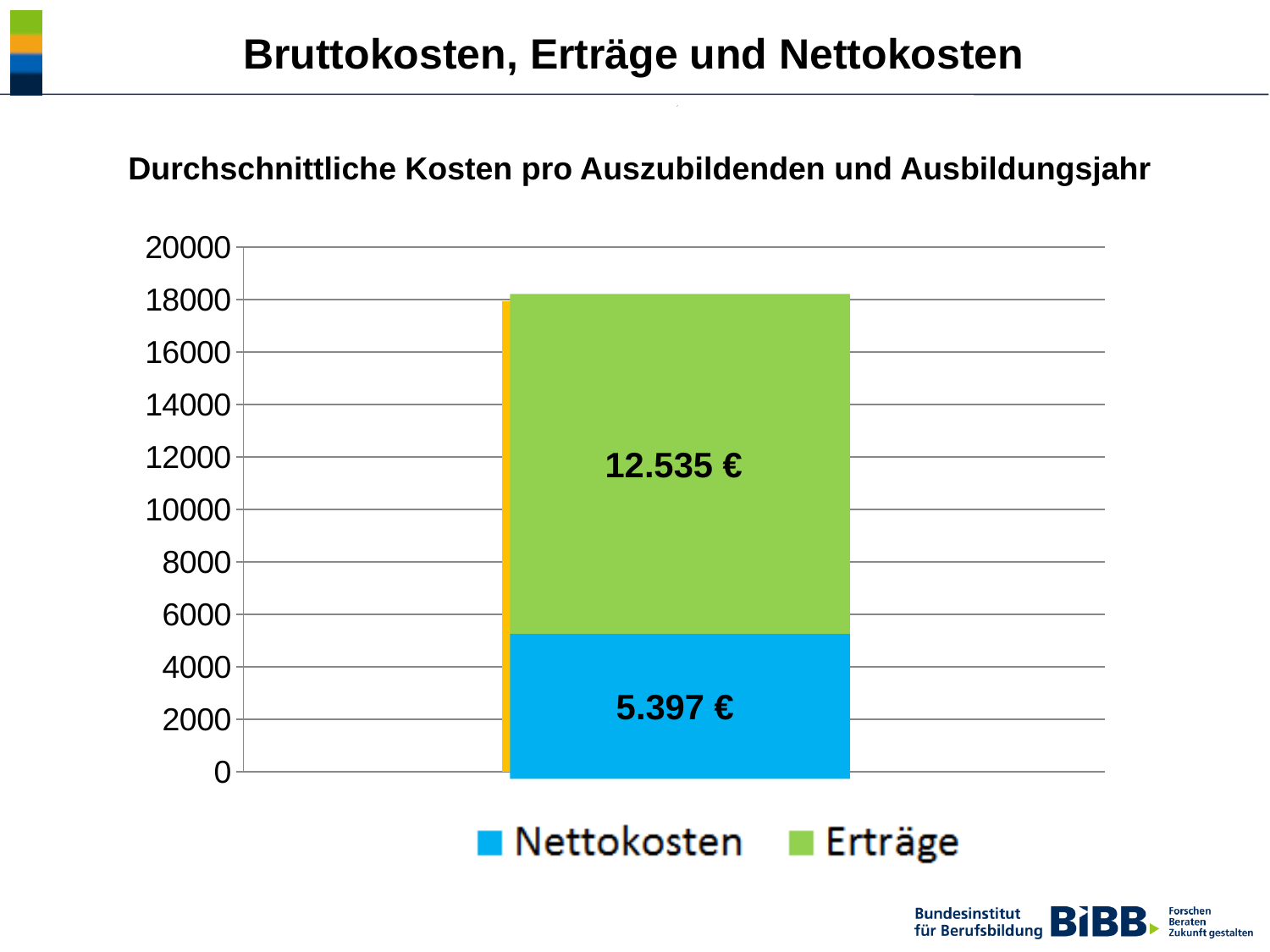
What kind of chart is shown on the slide? Stacked bar chart What is the total of the stacked bar (Nettokosten plus Erträge)? 17.932 € What is the value of the Nettokosten segment in the bar? 5.397 € Is the total height of the stacked bar greater or less than 16000? greater Which colour represents Erträge in the legend? Green Is the Nettokosten value greater or less than 6000? less What is the value of the Erträge segment in the bar? 12.535 € How many series does the legend list? 2 What is the title shown above the chart? Durchschnittliche Kosten pro Auszubildenden und Ausbildungsjahr What is the difference between the Erträge value and the Nettokosten value? 7.138 € Which series has the larger value, Nettokosten or Erträge? Erträge How many bars are plotted in the chart? 1